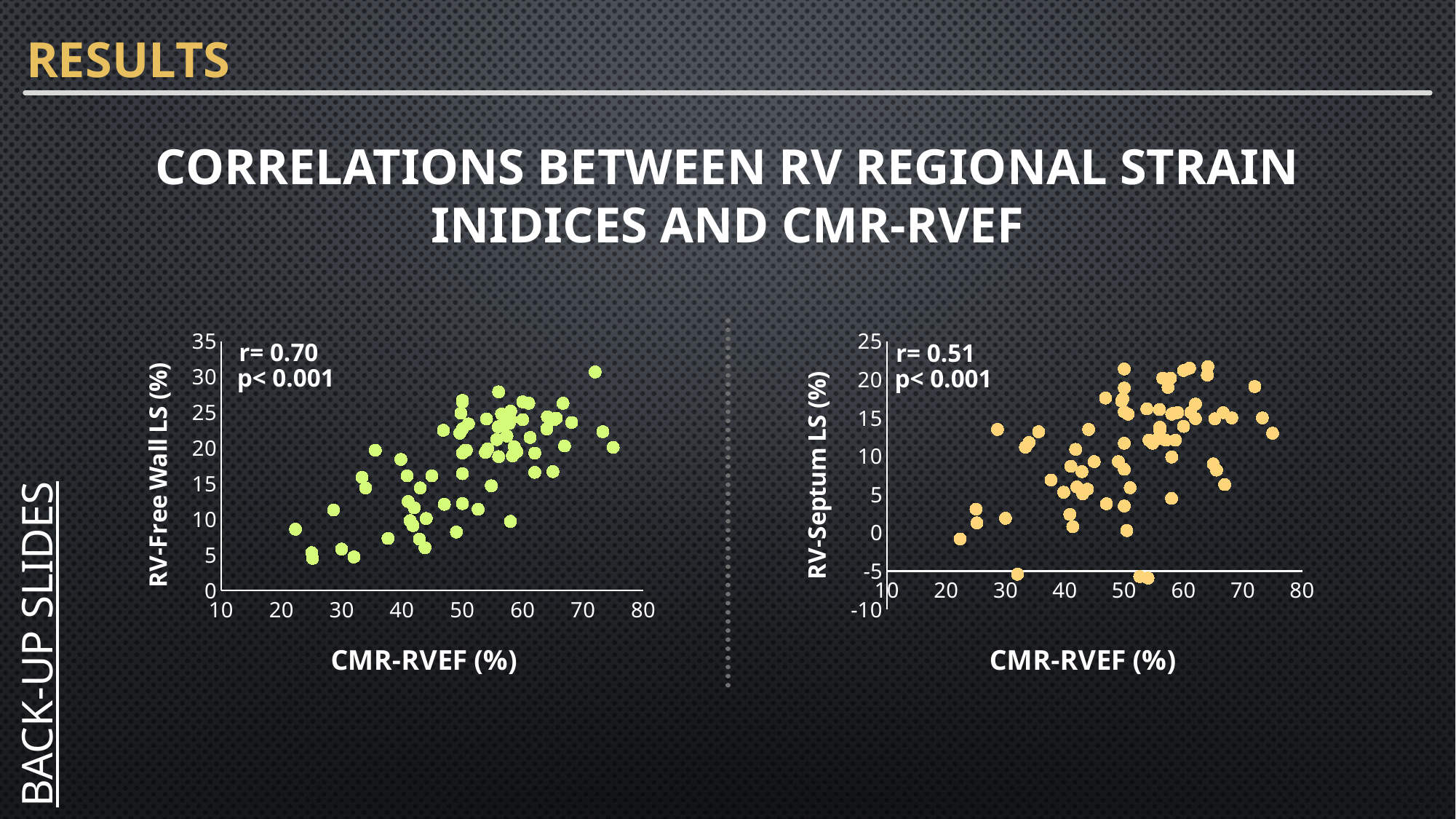
In the right chart (RV-Septum LS), do the values generally rise or fall as CMR-RVEF increases along the x axis? rise What kind of chart is the right chart, titled RV-Septum LS (%) against CMR-RVEF (%)? scatter chart In the left chart (RV-Free Wall LS), is the lowest plotted point greater or less than 10 on the y axis? less In the right chart (RV-Septum LS), is the lowest plotted point greater or less than 0 on the y axis? less What kind of chart is the left chart, titled RV-Free Wall LS (%) against CMR-RVEF (%)? scatter chart What is the maximum value shown on the y axis of the right chart (RV-Septum LS)? 25 In the left chart (RV-Free Wall LS), do the values generally rise or fall as CMR-RVEF increases along the x axis? rise Which chart shows the stronger correlation coefficient, the left chart (RV-Free Wall LS) or the right chart (RV-Septum LS)? the left chart (RV-Free Wall LS) What correlation coefficient r is printed on the right chart (RV-Septum LS)? r= 0.51 What correlation coefficient r is printed on the left chart (RV-Free Wall LS)? r= 0.70 In the left chart (RV-Free Wall LS), is the highest plotted point greater or less than 25 on the y axis? greater